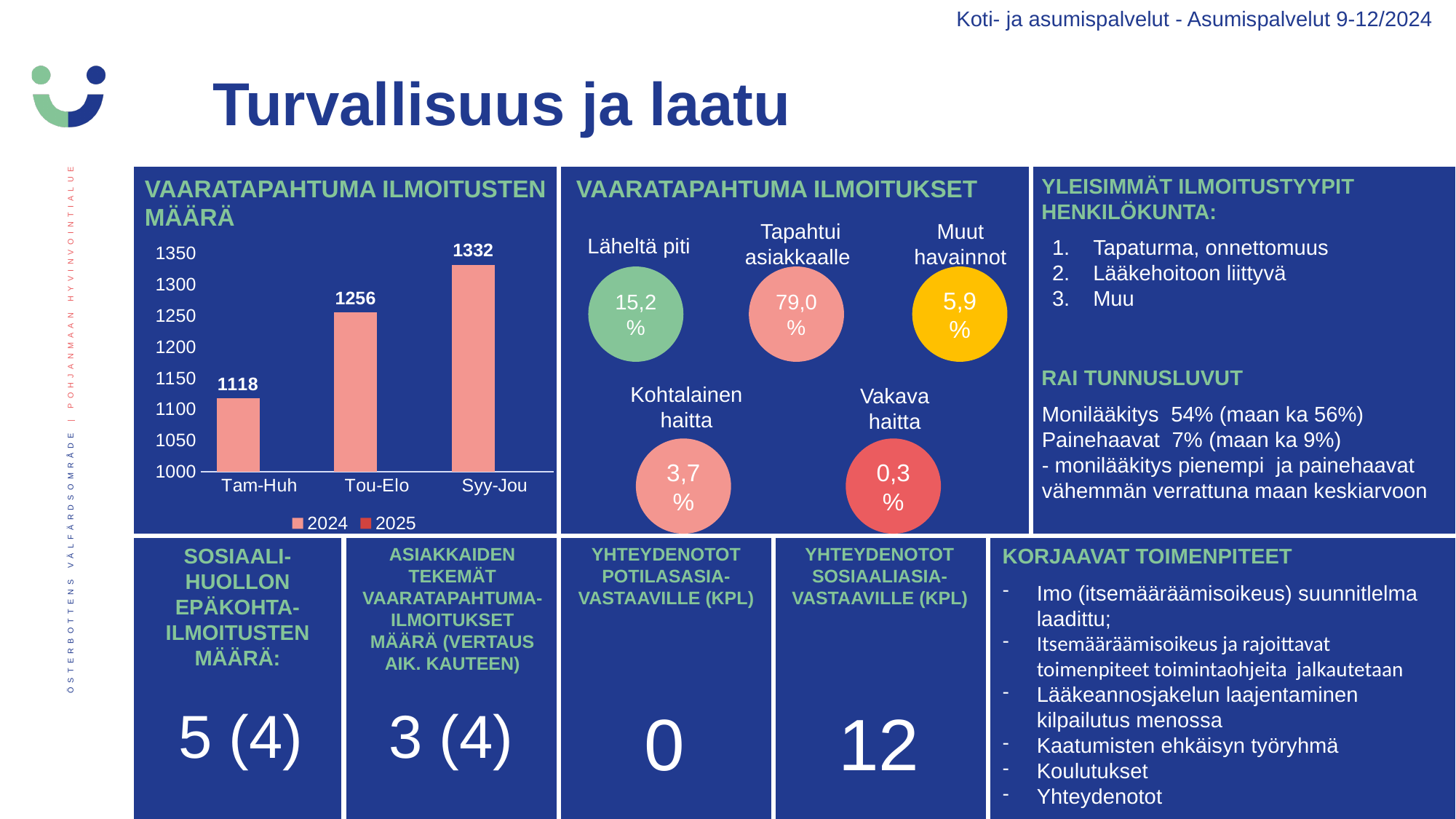
How many series does the legend of the chart 'VAARATAPAHTUMA ILMOITUSTEN MÄÄRÄ' list? 2 In the chart 'VAARATAPAHTUMA ILMOITUSTEN MÄÄRÄ', what is the value for Tam-Huh? 1118 In the chart 'VAARATAPAHTUMA ILMOITUSTEN MÄÄRÄ', what is the value for Tou-Elo? 1256 What kind of chart is 'VAARATAPAHTUMA ILMOITUSTEN MÄÄRÄ'? Bar chart In the chart 'VAARATAPAHTUMA ILMOITUSTEN MÄÄRÄ', which is larger, the value for Tou-Elo or the value for Syy-Jou? Syy-Jou In the chart 'VAARATAPAHTUMA ILMOITUSTEN MÄÄRÄ', what is the difference between the values for Syy-Jou and Tam-Huh? 214 In the chart 'VAARATAPAHTUMA ILMOITUSTEN MÄÄRÄ', do the values rise or fall from Tam-Huh to Syy-Jou? Rise In the chart 'VAARATAPAHTUMA ILMOITUSTEN MÄÄRÄ', what is the difference between the values for Tou-Elo and Tam-Huh? 138 In the chart 'VAARATAPAHTUMA ILMOITUSTEN MÄÄRÄ', which category has the lowest value? Tam-Huh In the chart 'VAARATAPAHTUMA ILMOITUSTEN MÄÄRÄ', how many categories are shown on the x axis? 3 In the chart 'VAARATAPAHTUMA ILMOITUSTEN MÄÄRÄ', what is the value for Syy-Jou? 1332 In the chart 'VAARATAPAHTUMA ILMOITUSTEN MÄÄRÄ', which category has the highest value? Syy-Jou